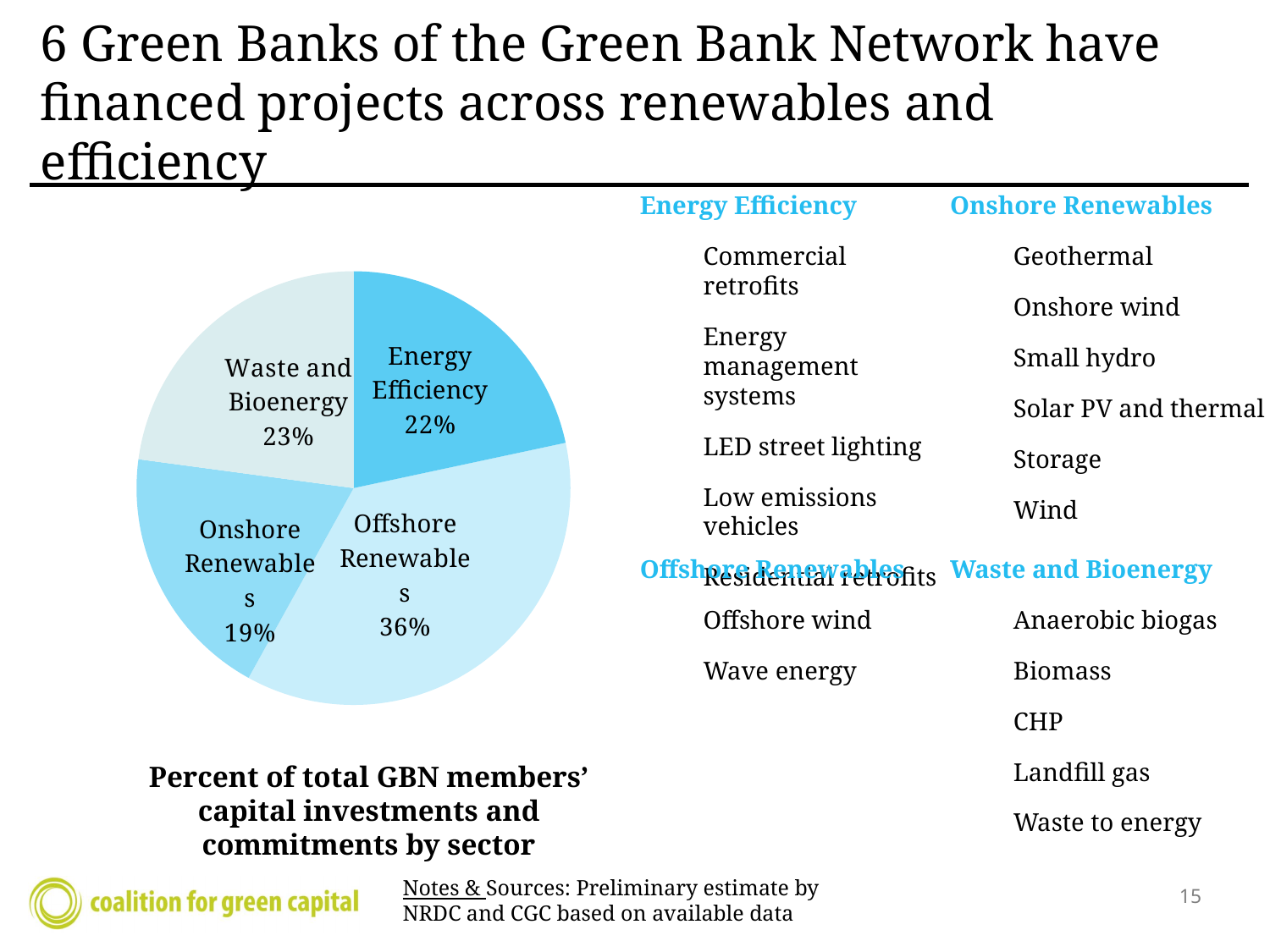
What percentage is shown for Waste and Bioenergy? 23% Which is larger, the share for Waste and Bioenergy or the share for Energy Efficiency? Waste and Bioenergy How many sectors are shown in the pie chart? 4 What share of the pie is Energy Efficiency? 22% What percentage is shown for Onshore Renewables? 19% What type of chart is shown on the slide? pie chart Which sector has the smallest share of the pie? Onshore Renewables What is the combined share of Energy Efficiency and Onshore Renewables? 41% What is the difference in percentage points between Offshore Renewables and Onshore Renewables? 17 What is the caption below the pie chart? Percent of total GBN members' capital investments and commitments by sector What share of total GBN members' capital investments and commitments goes to Offshore Renewables? 36% Which sector has the largest share of the pie? Offshore Renewables